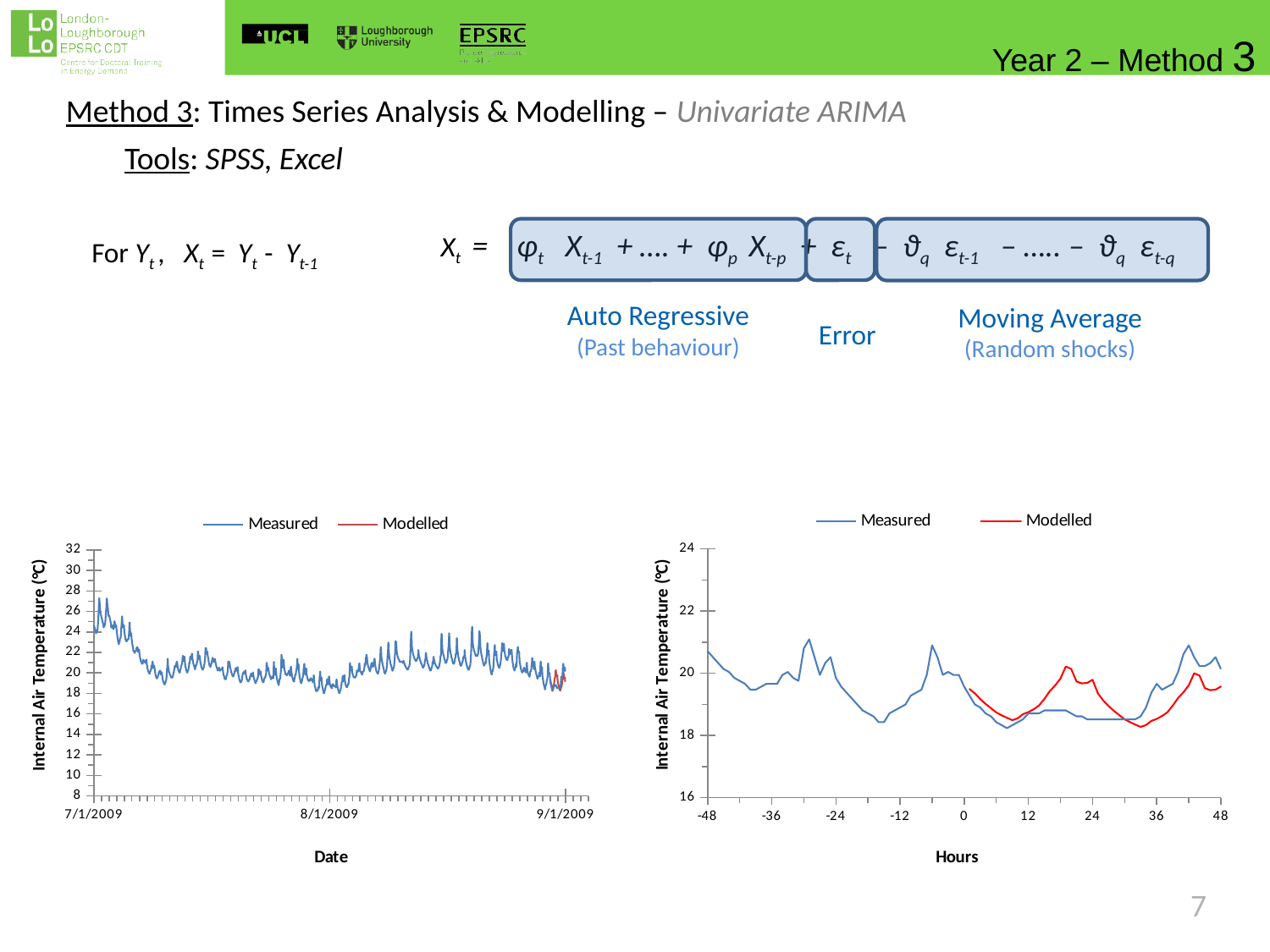
What kind of chart is the right chart (Internal Air Temperature vs Hours)? line chart In the right chart, is the Measured value at hour -48 greater or less than 20? greater In the right chart, is the Measured value at hour 12 greater or less than 20? less What is the x-axis title of the right chart? Hours In the left chart, is the Measured value at 9/1/2009 greater or less than 22? less What kind of chart is the left chart (Internal Air Temperature vs Date)? line chart In the right chart, which series has the larger value at hour 20, Measured or Modelled? Modelled How many series does the legend of the right chart list? 2 How many series does the legend of the left chart list? 2 What is the y-axis title of the left chart? Internal Air Temperature (°C) In the right chart, does the Measured series rise or fall between hour -48 and hour -36? fall